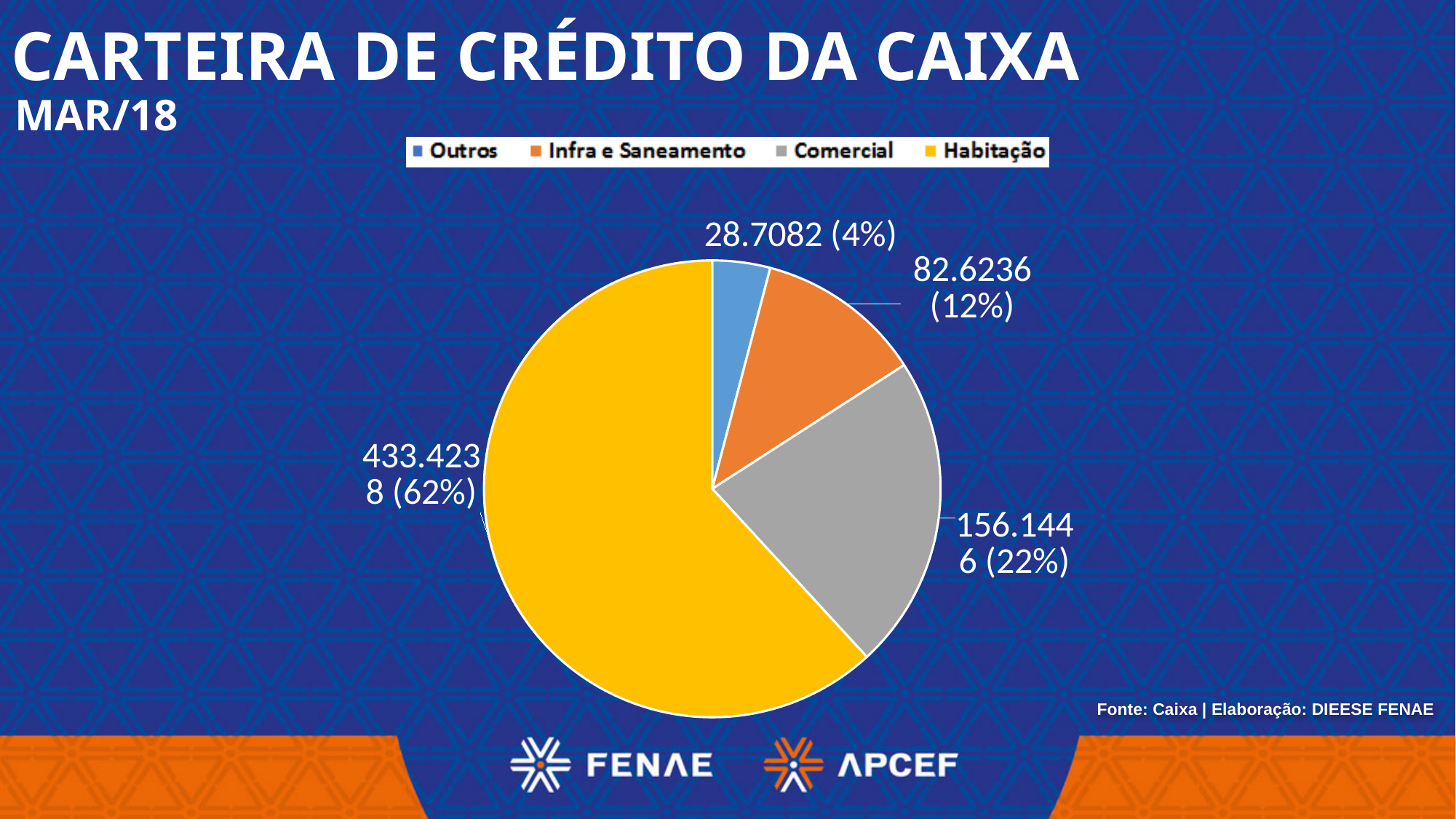
What value is shown for Outros? 28.7082 How many slices does the pie chart have? 4 Which is larger, the slice for Comercial or the slice for Infra e Saneamento? Comercial What share of the pie does Outros represent? 4% Which category has the smallest slice of the pie? Outros What share of the pie does Infra e Saneamento represent? 12% Which category has the largest slice of the pie? Habitação What share of the pie does Comercial represent? 22% What kind of chart is shown on the slide? pie chart What value is shown for Infra e Saneamento? 82.6236 How many entries does the legend list? 4